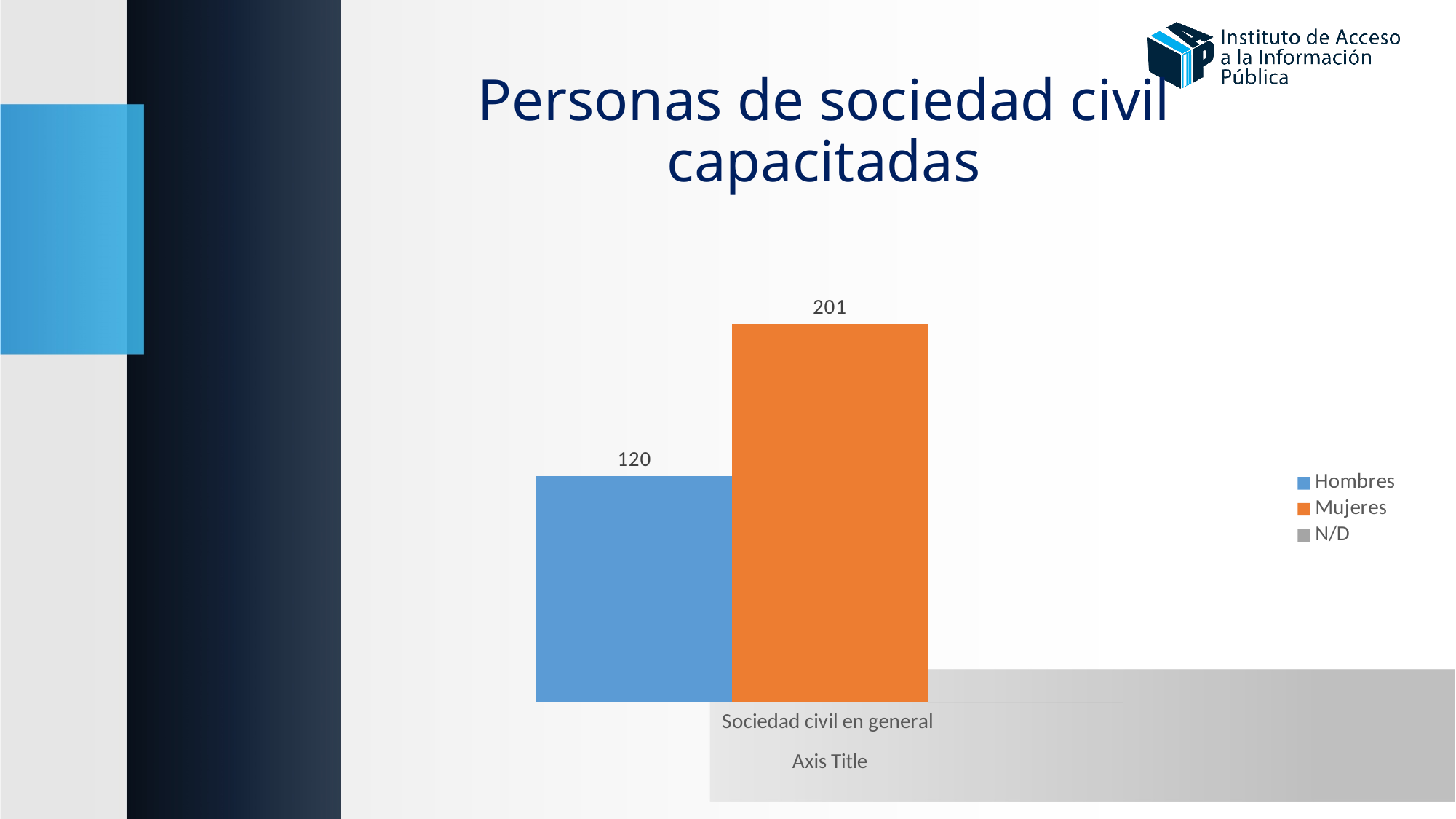
What kind of chart is shown on the slide? Bar chart What colour is the bar for Mujeres? Orange How many categories are shown on the x axis? 1 What is the difference between the Mujeres value and the Hombres value? 81 What is the label of the single category on the x axis? Sociedad civil en general What is the title of the slide above the chart? Personas de sociedad civil capacitadas Which series has the highest value in the chart? Mujeres What is the value for Hombres in the Sociedad civil en general category? 120 Which is larger, the value for Hombres or the value for Mujeres? Mujeres How many series does the legend list? 3 What is the value for Mujeres in the Sociedad civil en general category? 201 Which series has the lowest plotted value in the chart? Hombres